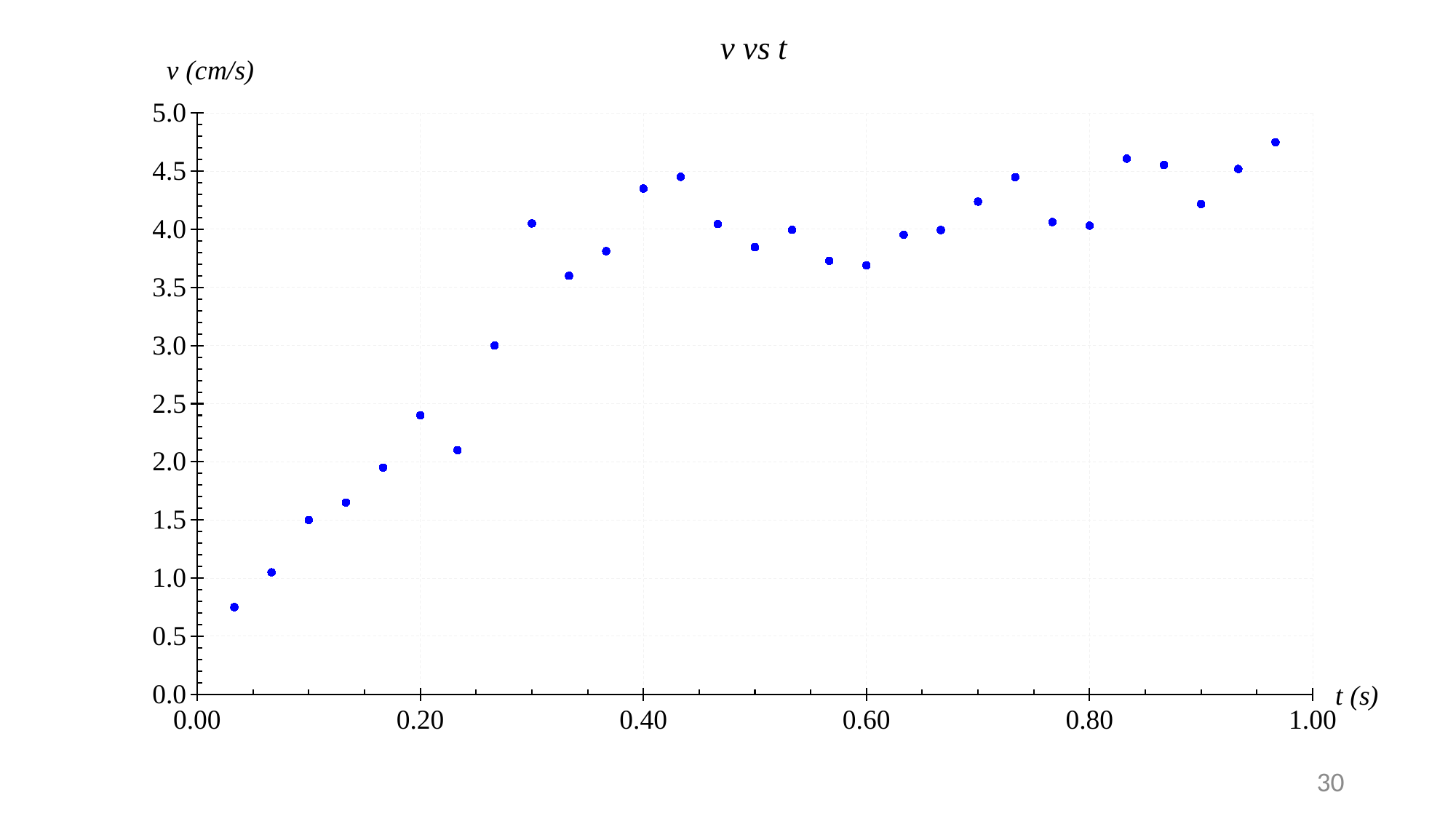
How many data points are plotted on the chart? 29 Overall, do the values of v rise or fall as t increases from 0.00 to 1.00? rise Is the value of v for the first data point (near t = 0.03) greater or less than 1.0? less Is the value of v at t = 0.60 greater or less than 4.0? less Is the value of v at t = 0.20 greater or less than 2.0? greater Which has the larger value of v: the point at t = 0.40 or the point at t = 0.60? t = 0.40 What is the title of the chart? v vs t What kind of chart is shown on the slide? scatter plot What is the label of the vertical axis? v (cm/s) Which has the larger value of v: the point at t = 0.20 or the point at t = 0.60? t = 0.60